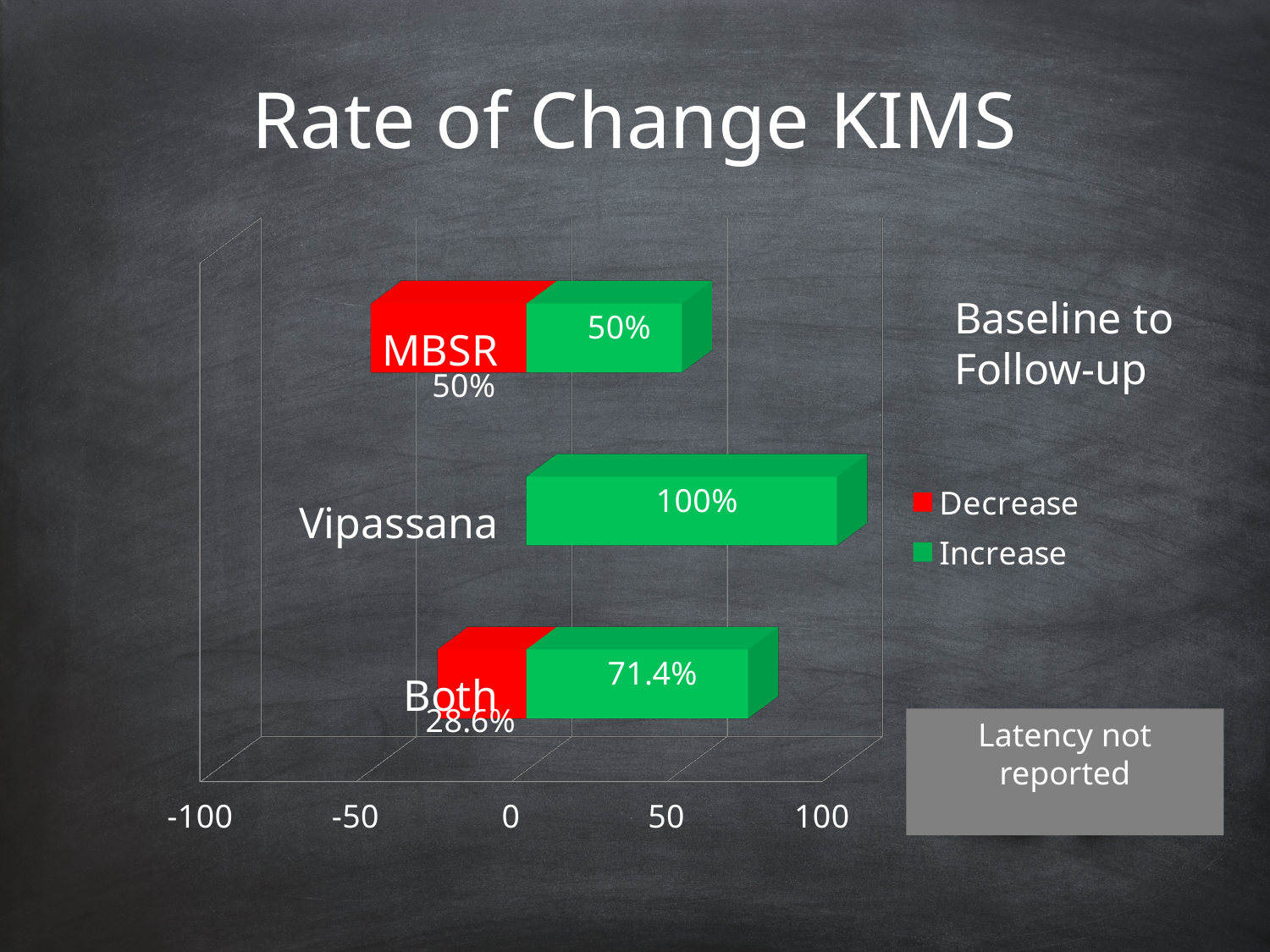
What kind of chart is shown on the slide? Bar chart What is the Decrease value for Both? 28.6% What is the Decrease value for MBSR? 50% How many series does the legend list? 2 Which is larger, the Increase value for Both or the Decrease value for Both? Increase (71.4%) Which category has the lowest Increase value? MBSR What is the Increase value for Vipassana? 100% How many categories are shown on the chart? 3 Which category has the highest Increase value? Vipassana What is the Increase value for Both? 71.4% What is the Increase value for MBSR? 50% What is the difference between the Increase values for Vipassana and Both? 28.6%